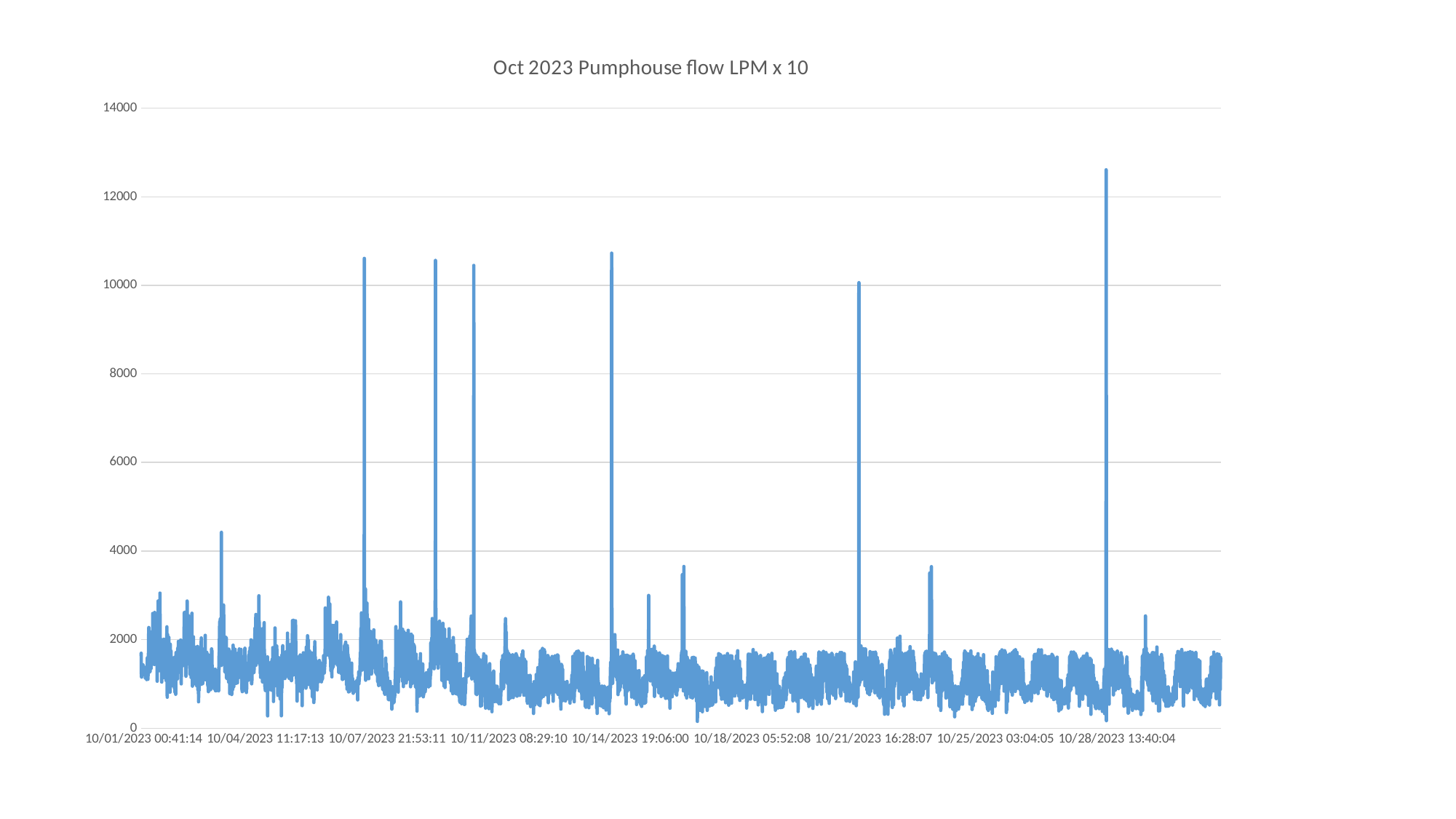
How many date labels are shown along the x axis? 9 Near which x-axis label does the tallest spike occur? 10/28/2023 13:40:04 Is the spike near the 10/07/2023 21:53:11 tick greater or less than 10000? greater What is the title of the chart? Oct 2023 Pumphouse flow LPM x 10 Is the tallest spike in the chart greater or less than 12000? greater What is the highest value shown on the vertical axis? 14000 Is the spike that occurs just before the 10/04/2023 11:17:13 tick greater or less than 6000? less Which is larger: the spike just after 10/28/2023 13:40:04 or the spike near 10/07/2023 21:53:11? The spike just after 10/28/2023 13:40:04 What type of chart is shown on the slide? Line chart How many spikes in the chart rise above 8000? 6